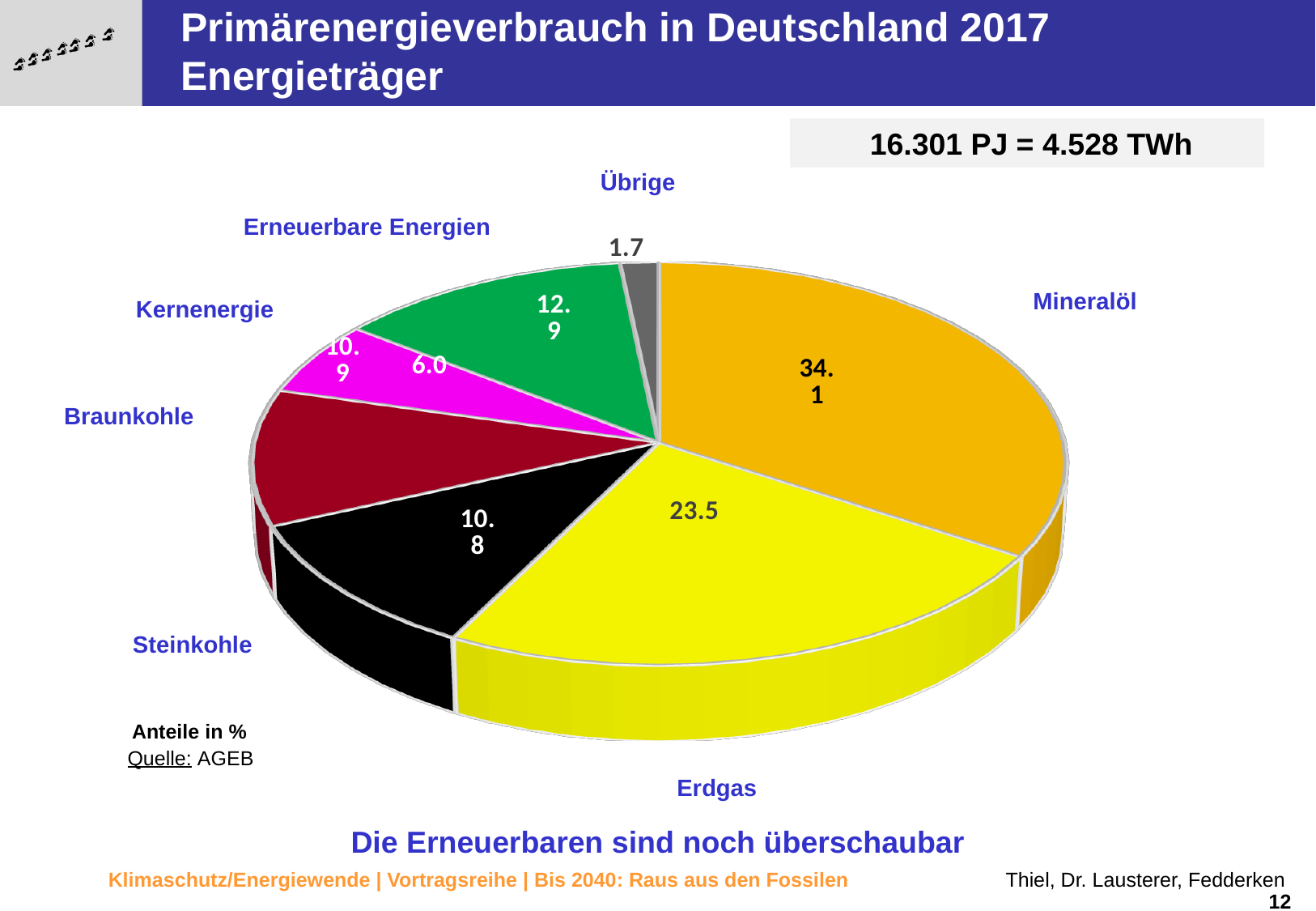
What is the difference between the shares of Mineralöl and Erdgas? 10.6 What is the share for Erdgas? 23.5 Which energy source has the smallest slice of the pie? Übrige What kind of chart is shown on the slide? pie chart What is the share for Mineralöl? 34.1 What is the share for Erneuerbare Energien? 12.9 Which energy source has the largest slice of the pie? Mineralöl What total primary energy consumption is stated on the slide? 16.301 PJ = 4.528 TWh What is the share for Steinkohle? 10.8 Which is larger, the share of Erneuerbare Energien or the share of Kernenergie? Erneuerbare Energien How many energy sources (slices) does the pie chart show? 7 What is the share for Übrige? 1.7